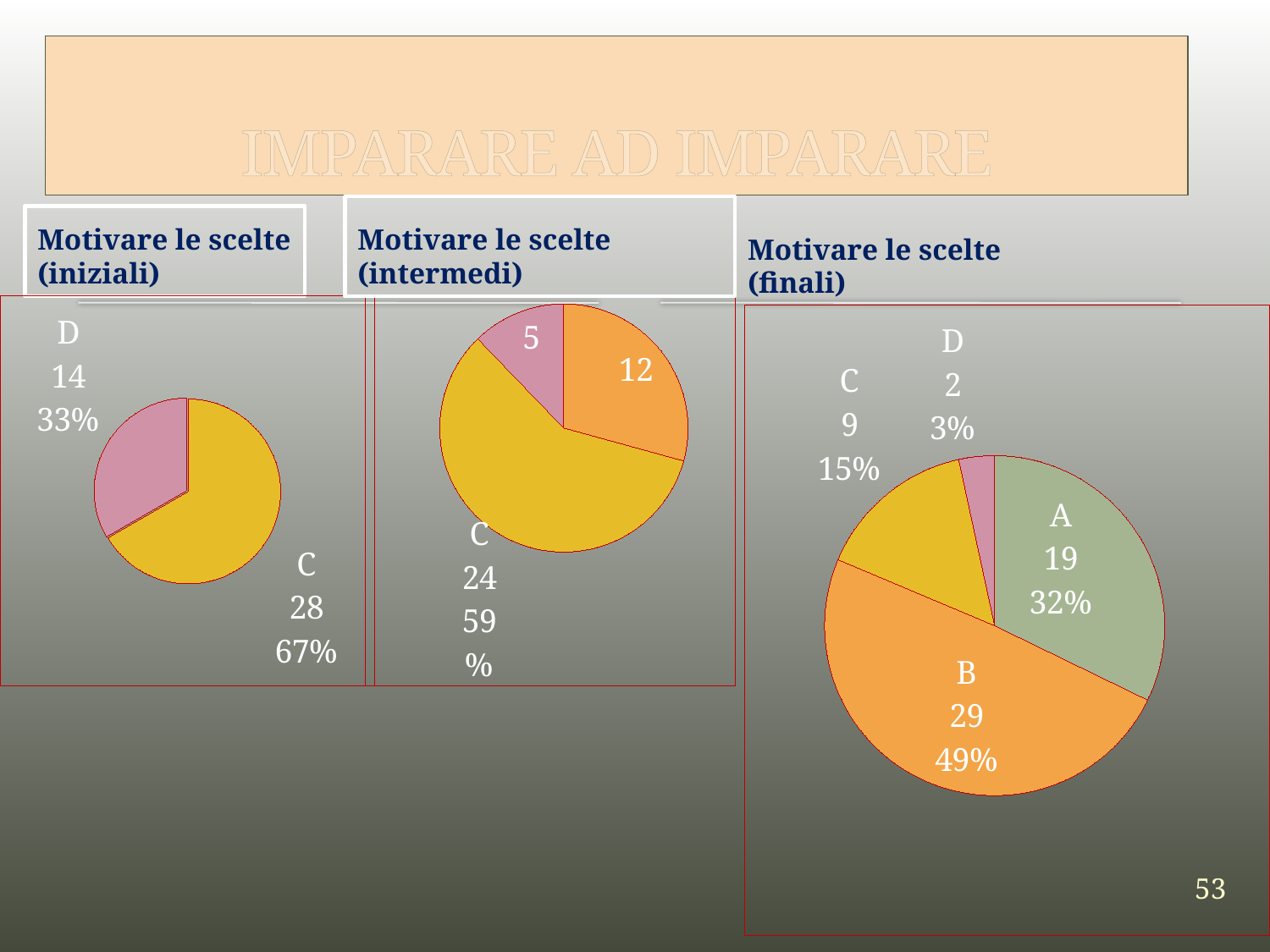
In the 'Motivare le scelte (iniziali)' chart, what percentage share does category D have? 33% In the 'Motivare le scelte (iniziali)' chart, what is the difference between the values for C and D? 14 In the 'Motivare le scelte (intermedi)' chart, what percentage share does category C have? 59% In the 'Motivare le scelte (iniziali)' chart, what value is shown for category C? 28 In the 'Motivare le scelte (finali)' chart, what value is shown for category B? 29 In the 'Motivare le scelte (iniziali)' chart, which category has the larger slice, C or D? C In the 'Motivare le scelte (intermedi)' chart, what value is shown for category C? 24 In the 'Motivare le scelte (finali)' chart, which category has the smallest slice? D In the 'Motivare le scelte (finali)' chart, which category has the largest slice? B In the 'Motivare le scelte (intermedi)' chart, how many slices does the pie have? 3 In the 'Motivare le scelte (finali)' chart, what percentage share does category A have? 32% What kind of chart is used in the 'Motivare le scelte (finali)' panel? Pie chart